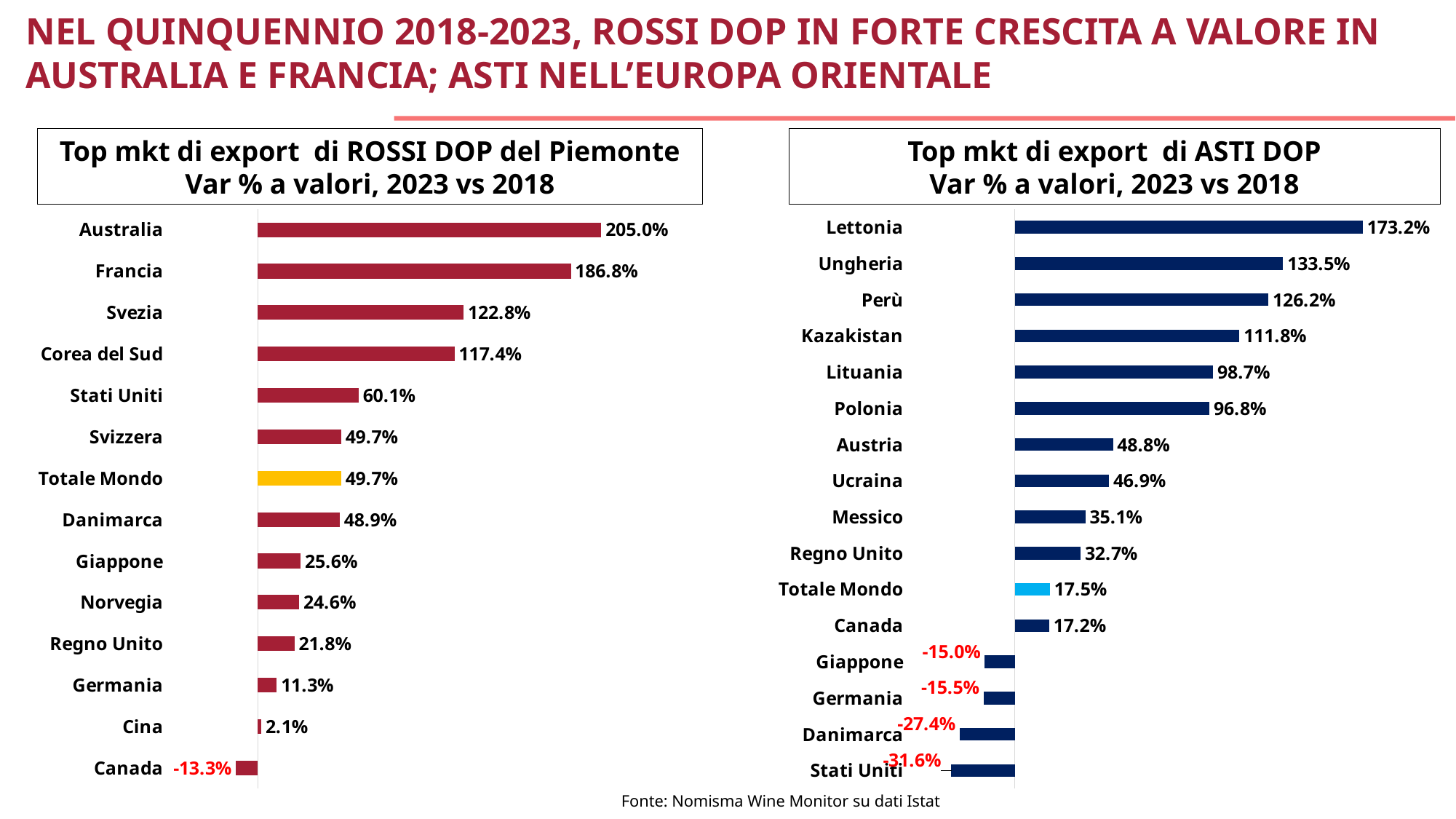
In the chart 'Top mkt di export di ASTI DOP', what is the value for Kazakistan? 111.8% In the chart 'Top mkt di export di ROSSI DOP del Piemonte', which country has the lowest value? Canada In the chart 'Top mkt di export di ASTI DOP', which country has the lowest value? Stati Uniti In the chart 'Top mkt di export di ASTI DOP', which is larger, the value for Messico or the value for Austria? Austria In the chart 'Top mkt di export di ROSSI DOP del Piemonte', what is the difference between the values for Australia and Francia? 18.2 percentage points In the chart 'Top mkt di export di ASTI DOP', what is the difference between the values for Lettonia and Ungheria? 39.7 percentage points How many countries/categories are shown in the chart 'Top mkt di export di ROSSI DOP del Piemonte'? 14 In the chart 'Top mkt di export di ROSSI DOP del Piemonte', which is larger, the value for Svezia or the value for Stati Uniti? Svezia What type of chart is 'Top mkt di export di ASTI DOP'? Bar chart In the chart 'Top mkt di export di ROSSI DOP del Piemonte', what is the value for Australia? 205.0% In the chart 'Top mkt di export di ASTI DOP', which country has the highest value? Lettonia How many countries/categories are shown in the chart 'Top mkt di export di ASTI DOP'? 16